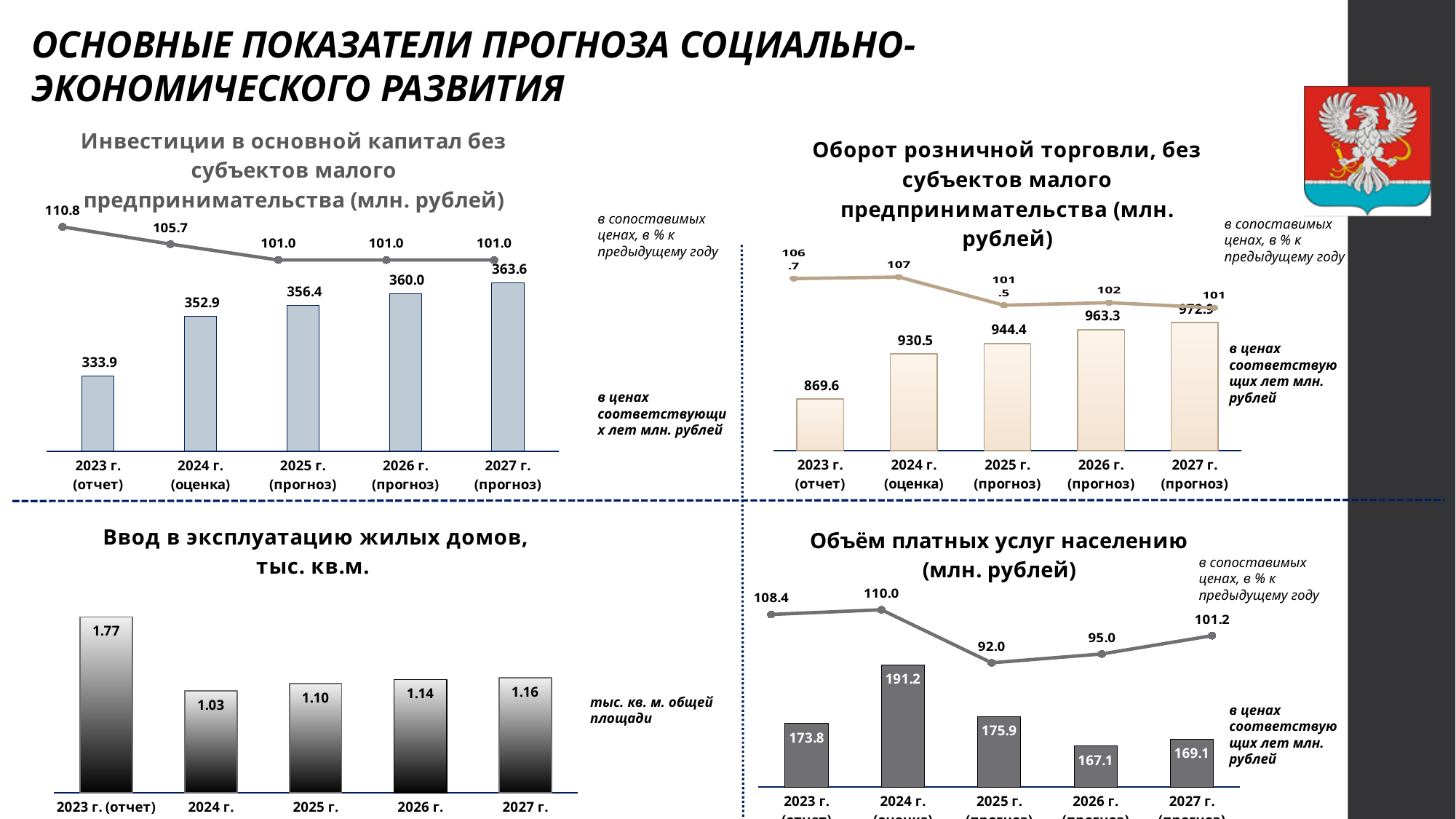
In the top-left chart on investments in fixed capital, what is the difference between the bar values for 2027 г. and 2023 г.? 29.7 In the top-left chart on investments in fixed capital, which year has the highest bar value? 2027 г. (прогноз) In the top-left chart on investments in fixed capital, what is the line value (in % to the previous year) for 2024 г. (оценка)? 105.7 In the bottom-left chart on housing commissioning, which year has the lowest value? 2024 г. In the top-right chart on retail trade turnover, do the bar values rise or fall from 2023 г. to 2027 г.? rise In the top-right chart on retail trade turnover, which year has the lowest bar value? 2023 г. (отчет) In the bottom-right chart on paid services to the population (Объём платных услуг населению), what is the bar value for 2024 г. (оценка)? 191.2 In the bottom-left chart on housing commissioning (Ввод в эксплуатацию жилых домов), what is the value for 2023 г. (отчет)? 1.77 In the top-right chart on retail trade turnover (Оборот розничной торговли), what is the bar value for 2026 г. (прогноз)? 963.3 How many charts are shown on the slide? 4 In the bottom-right chart on paid services to the population, which is larger: the bar value for 2025 г. or for 2026 г.? 2025 г. In the top-left chart on investments in fixed capital (Инвестиции в основной капитал), what is the bar value for 2023 г. (отчет)? 333.9